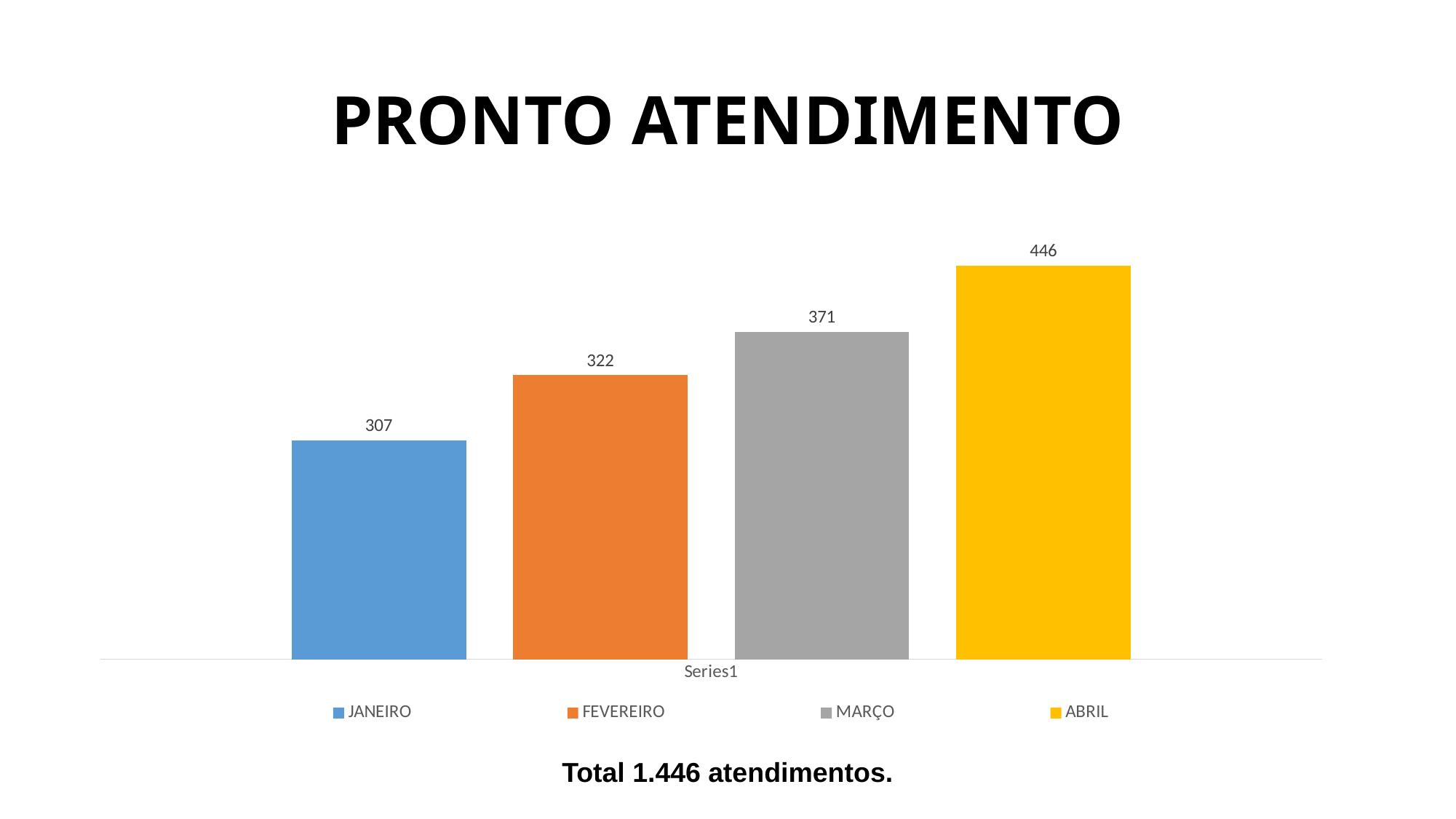
What is the value for ABRIL? 446 What is the value for MARÇO? 371 How many bars are plotted in the chart? 4 What is the value for JANEIRO? 307 Which month has the lowest value? JANEIRO What is the value for FEVEREIRO? 322 What kind of chart is shown on the slide? Bar chart What is the difference between the values for ABRIL and JANEIRO? 139 Which is larger, the value for MARÇO or the value for FEVEREIRO? MARÇO Which month has the highest value? ABRIL What is the difference between the values for MARÇO and FEVEREIRO? 49 Do the values rise or fall from JANEIRO to ABRIL? Rise